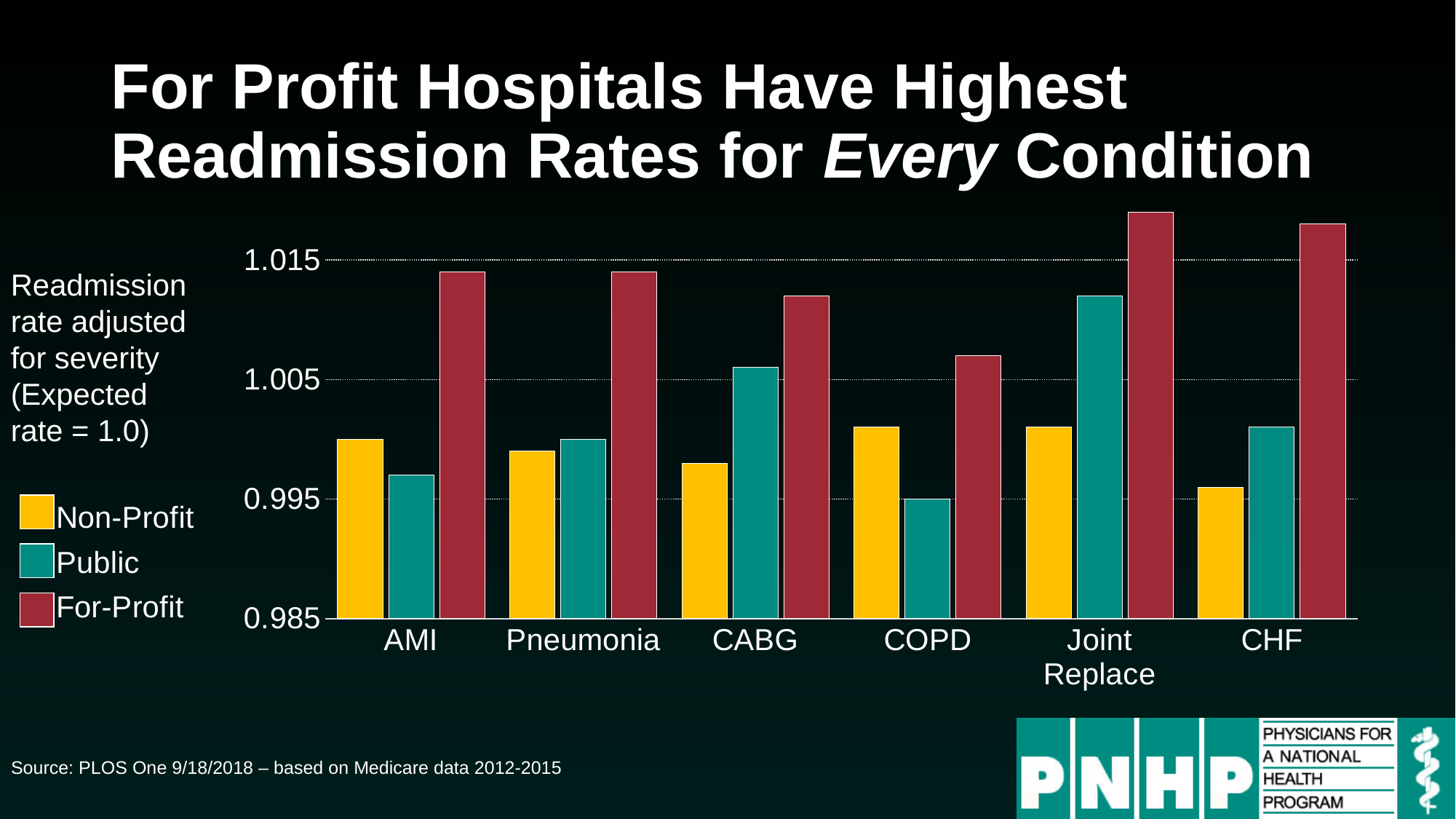
Is the Non-Profit value for AMI greater or less than 1.005? less Is the For-Profit value for COPD greater or less than 1.005? greater Is the Public value for CABG greater or less than 1.005? greater For which condition is the For-Profit readmission rate the highest? Joint Replace Which hospital type has the highest readmission rate for every condition in the chart? For-Profit Which colour represents the For-Profit series in the chart? red Which is larger for COPD, the Non-Profit value or the Public value? Non-Profit How many conditions are shown along the x axis of the chart? 6 What kind of chart is shown on the slide? bar chart How many series does the chart's legend list? 3 Which is larger for CHF, the Non-Profit value or the Public value? Public